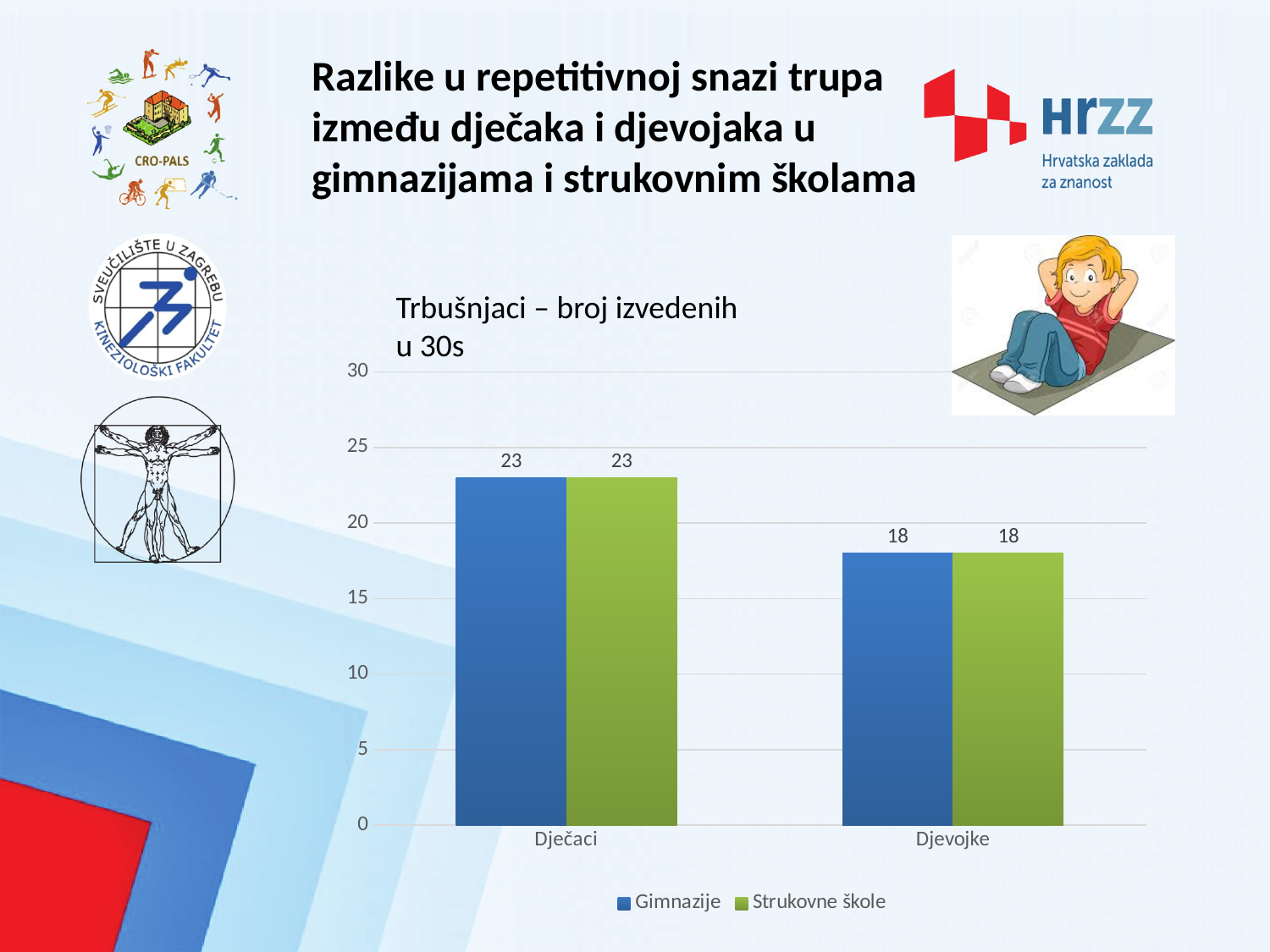
Is the value for Strukovne škole in the Djevojke category greater or less than 20? less What is the value for Strukovne škole in the Dječaci category? 23 What is the title of the chart? Trbušnjaci – broj izvedenih u 30s What is the value for Gimnazije in the Dječaci category? 23 What is the difference between the Gimnazije values for Dječaci and Djevojke? 5 Which category has the higher value for Gimnazije, Dječaci or Djevojke? Dječaci What is the value for Gimnazije in the Djevojke category? 18 How many series does the legend list? 2 What is the value for Strukovne škole in the Djevojke category? 18 What is the difference between the Strukovne škole values for Dječaci and Djevojke? 5 How many categories are shown on the x axis? 2 What kind of chart is shown on the slide? bar chart